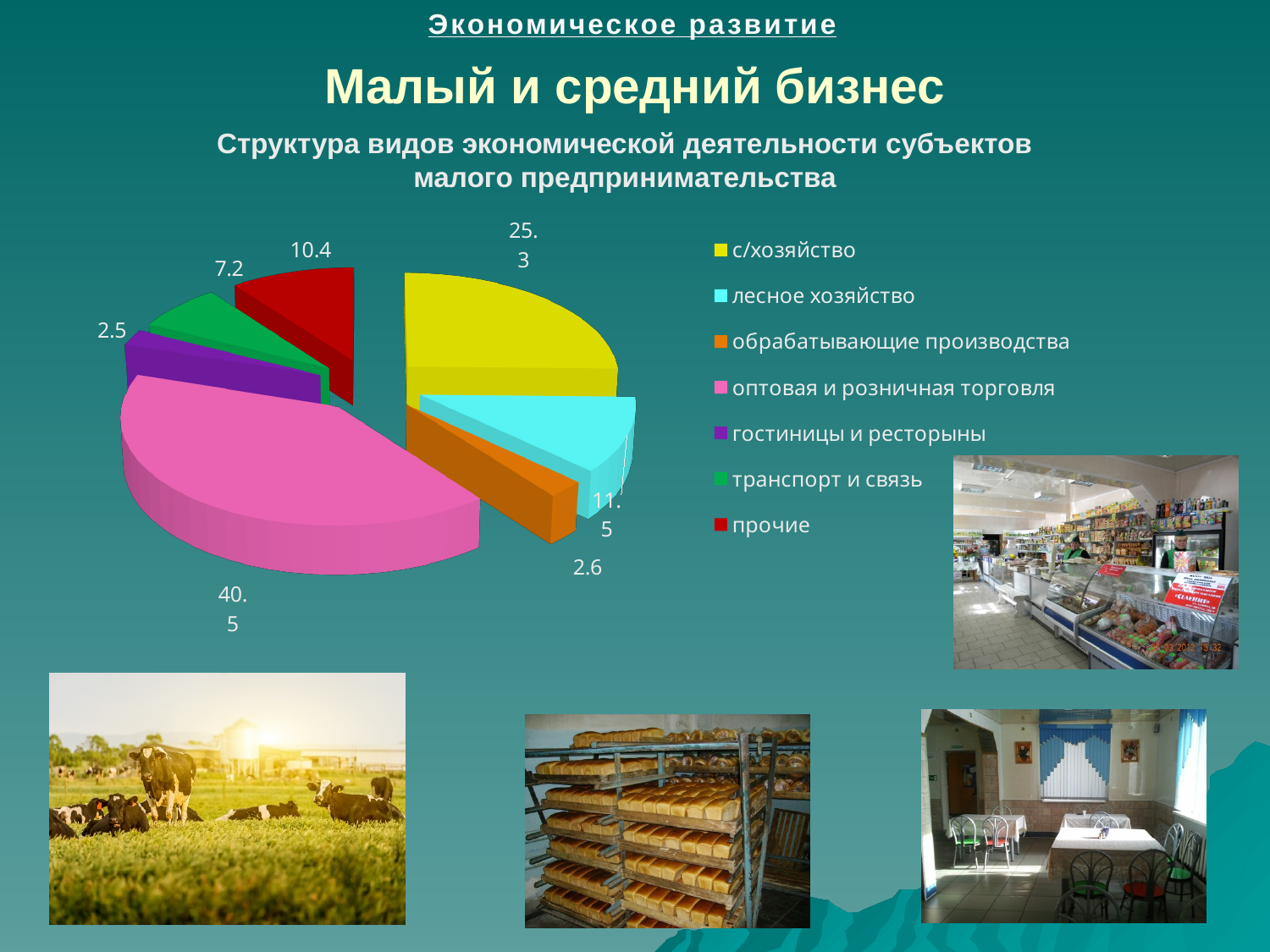
What is the value for оптовая и розничная торговля? 40.5 What is the value for с/хозяйство? 25.3 Which is larger, the value for прочие or the value for транспорт и связь? прочие What colour is the slice for обрабатывающие производства? orange What is the value for лесное хозяйство? 11.5 How many entries does the legend list? 7 Which category has the smallest slice of the pie? гостиницы и ресторыны What is the difference between the values for оптовая и розничная торговля and с/хозяйство? 15.2 Which category has the largest slice of the pie? оптовая и розничная торговля How many slices does the pie chart have? 7 What is the value for транспорт и связь? 7.2 What type of chart is shown on the slide? pie chart